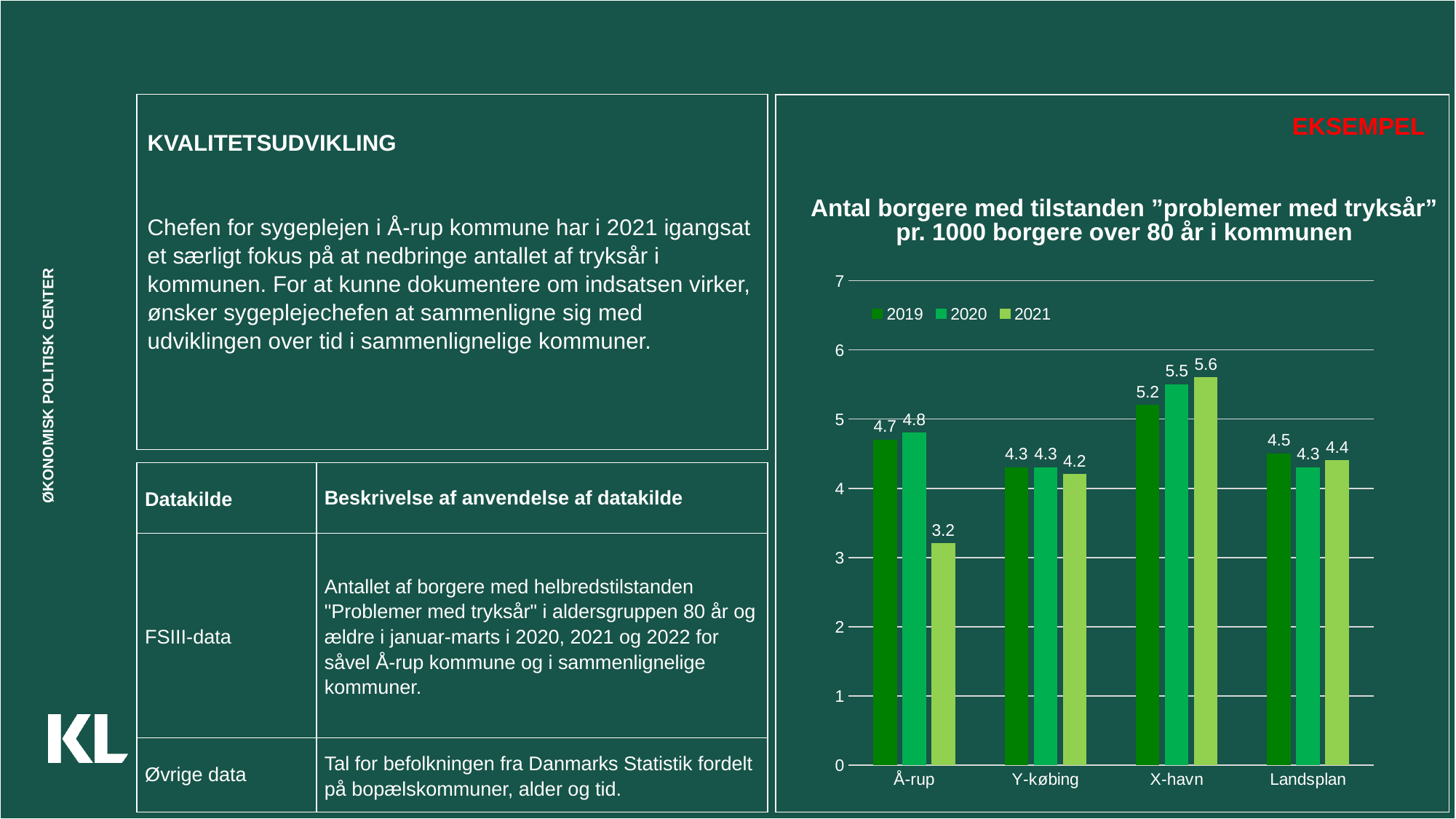
What is the difference between the 2019 and 2021 values for Å-rup? 1.5 How many series does the legend list? 3 Which is larger, the 2021 value for Y-købing or the 2021 value for Landsplan? Landsplan What is the value for Å-rup in 2021? 3.2 What is the value for X-havn in 2020? 5.5 What years are listed in the chart legend? 2019, 2020, 2021 What kind of chart is shown on the slide? Bar chart Which category has the lowest value in 2021? Å-rup Do the values for Å-rup rise or fall from 2020 to 2021? Fall How many categories are shown on the x axis? 4 What is the value for Landsplan in 2019? 4.5 Which category has the highest value in 2021? X-havn